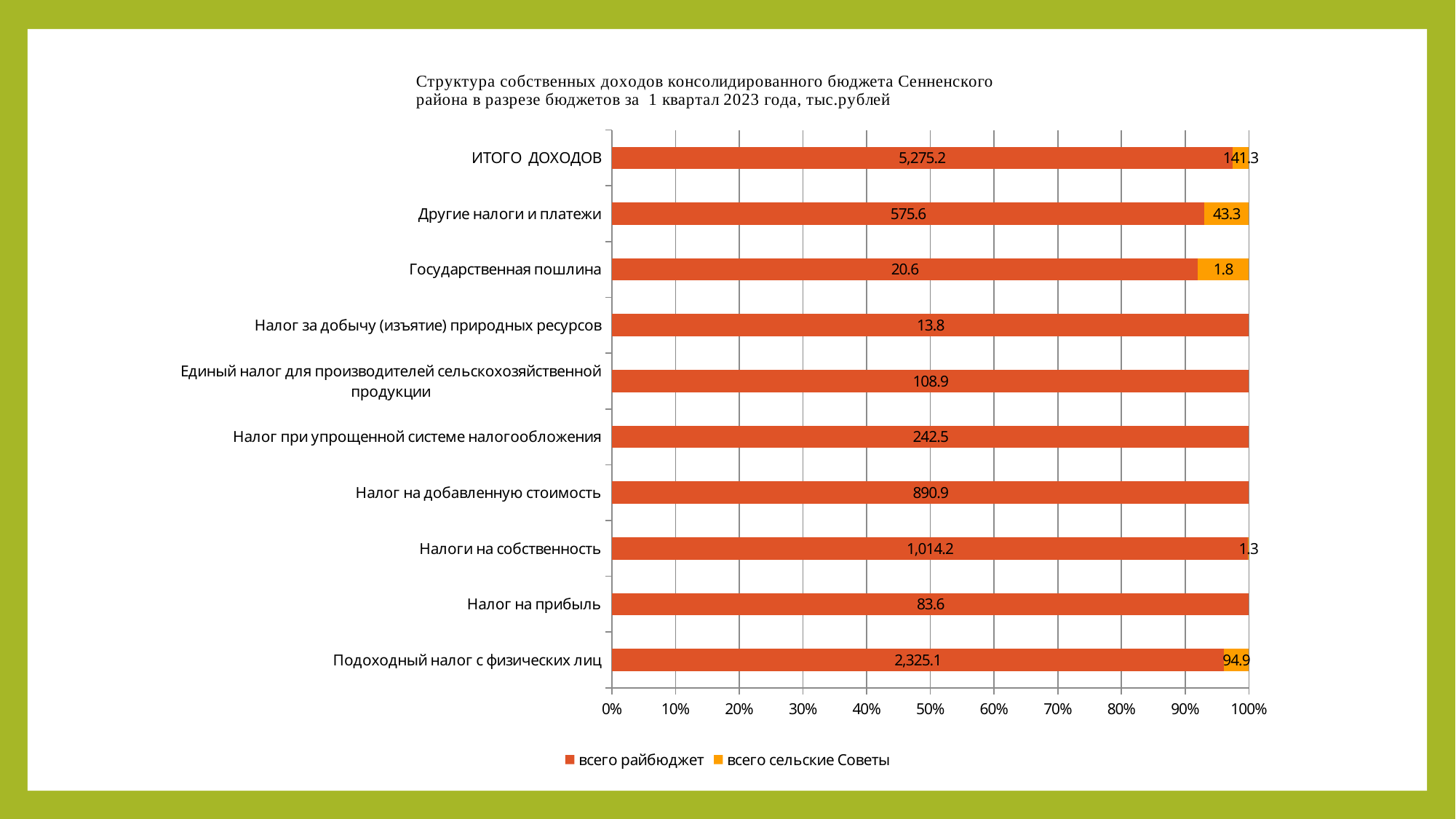
What is the value of "всего райбюджет" for "ИТОГО ДОХОДОВ"? 5,275.2 What kind of chart is shown on the slide? Stacked bar chart What is the value of "всего сельские Советы" for "Государственная пошлина"? 1.8 What is the difference between the "всего райбюджет" values for "Подоходный налог с физических лиц" and "Налоги на собственность"? 1,310.9 What is the total of the two series for "Другие налоги и платежи"? 618.9 Excluding "ИТОГО ДОХОДОВ", which category has the highest "всего райбюджет" value? Подоходный налог с физических лиц Which category has the lowest "всего райбюджет" value? Налог за добычу (изъятие) природных ресурсов Which has the larger "всего райбюджет" value: "Налог на добавленную стоимость" or "Налоги на собственность"? Налоги на собственность What is the value of "всего райбюджет" for "Подоходный налог с физических лиц"? 2,325.1 How many series does the legend list? 2 How many categories are shown on the chart? 10 What is the value of "всего сельские Советы" for "Другие налоги и платежи"? 43.3